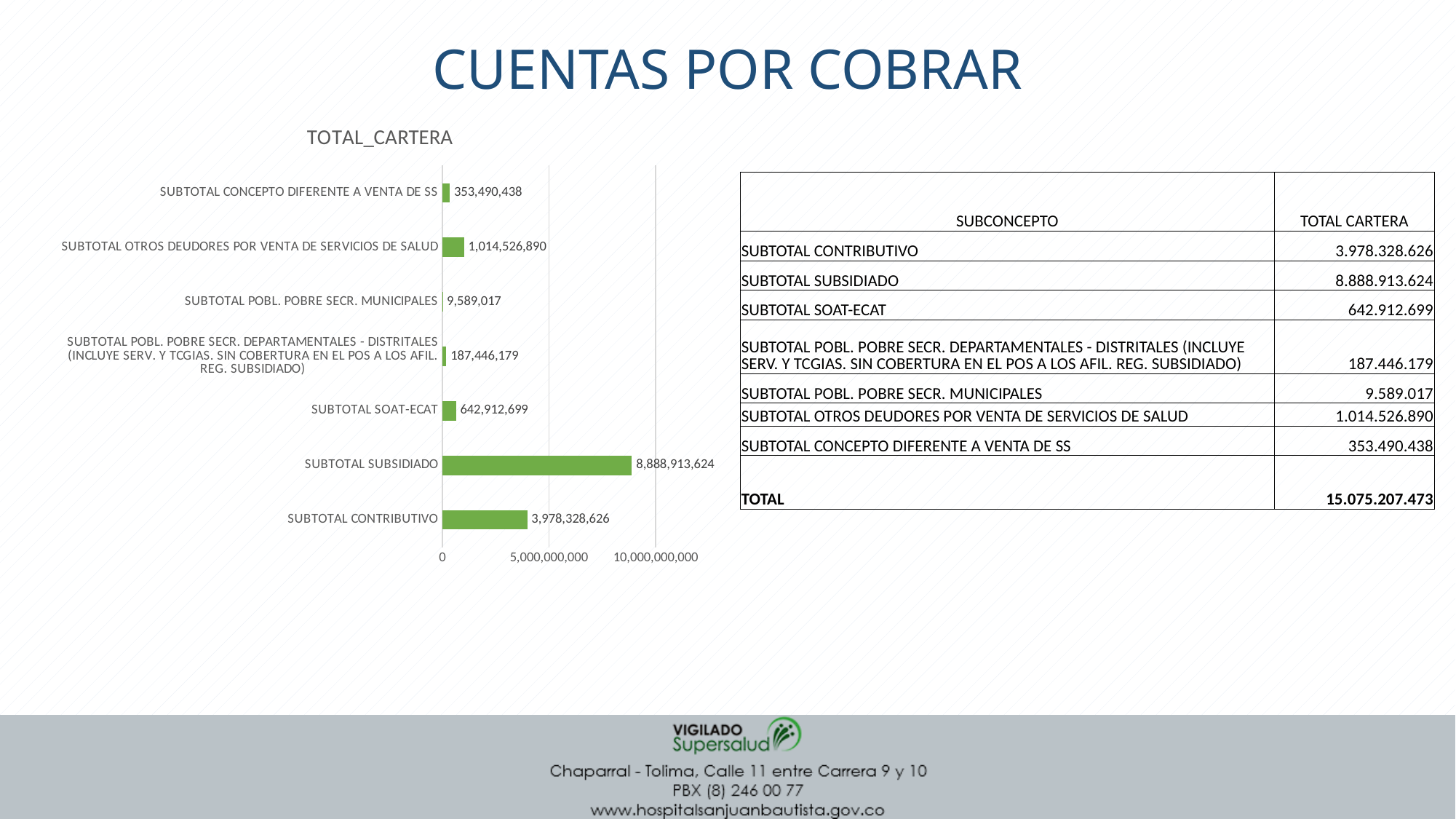
What type of chart is shown on the slide? Bar chart What is the value for SUBTOTAL CONTRIBUTIVO in the chart? 3,978,328,626 What is the title of the chart? TOTAL_CARTERA Which category has the lowest value in the chart? SUBTOTAL POBL. POBRE SECR. MUNICIPALES What is the value for SUBTOTAL SUBSIDIADO in the chart? 8,888,913,624 What is the value for SUBTOTAL SOAT-ECAT in the chart? 642,912,699 Is the value for SUBTOTAL CONTRIBUTIVO greater or less than 5,000,000,000? less What is the difference between the values for SUBTOTAL SUBSIDIADO and SUBTOTAL CONTRIBUTIVO? 4,910,584,998 How many categories are plotted in the chart? 7 What is the value for SUBTOTAL POBL. POBRE SECR. MUNICIPALES in the chart? 9,589,017 Which category has the highest value in the chart? SUBTOTAL SUBSIDIADO Which is larger, the value for SUBTOTAL OTROS DEUDORES POR VENTA DE SERVICIOS DE SALUD or the value for SUBTOTAL SOAT-ECAT? SUBTOTAL OTROS DEUDORES POR VENTA DE SERVICIOS DE SALUD